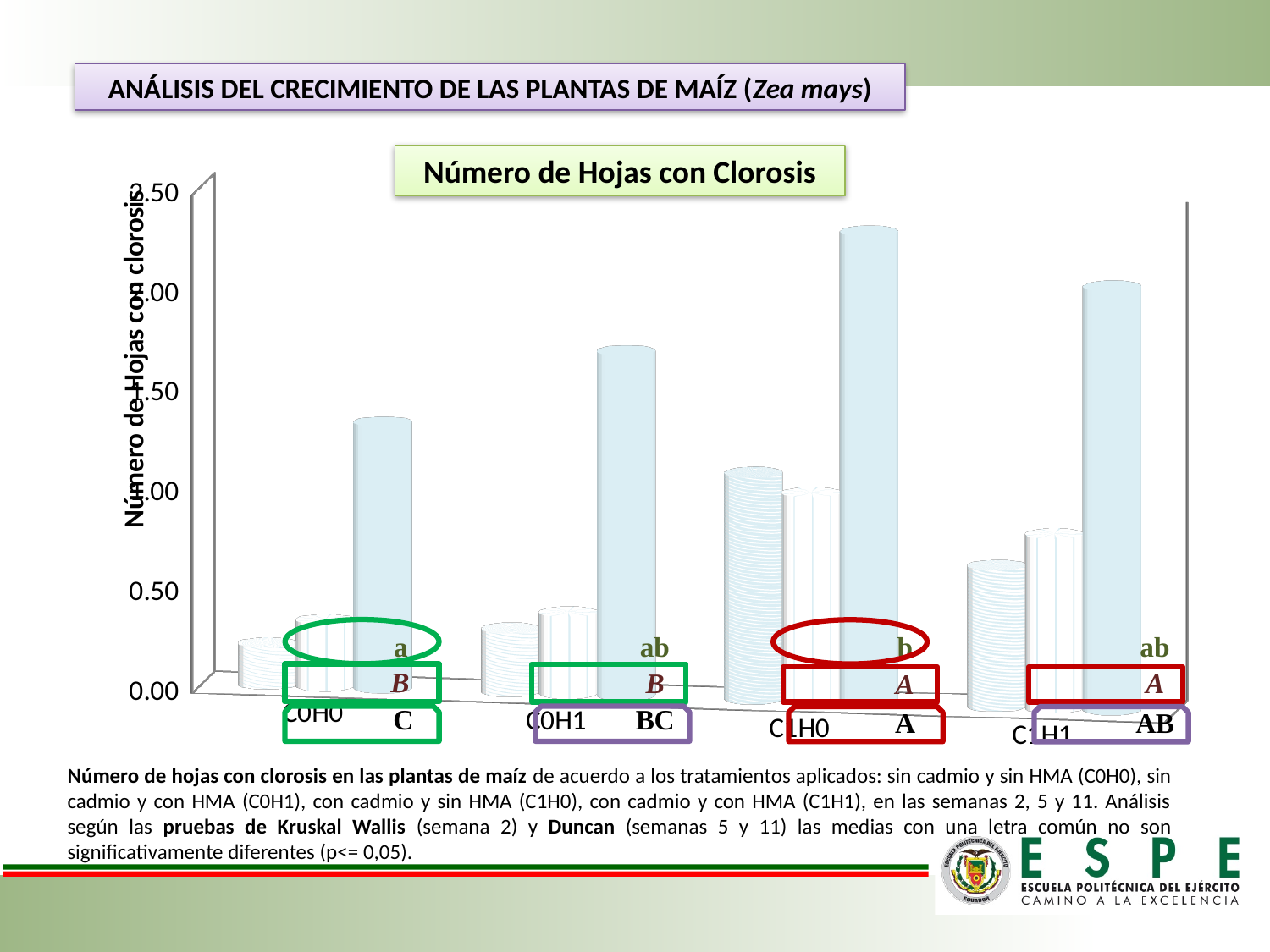
How many bars are plotted for each treatment category in the chart? 3 Is the tallest bar for C0H0 greater or less than 1.00? greater Which has the taller tallest bar, C1H0 or C0H0? C1H0 Is the shortest bar for C0H1 greater or less than 0.50? less What kind of chart is shown on the slide? bar chart Which treatment category contains the shortest bar in the chart? C0H0 What is the title of the chart? Número de Hojas con Clorosis Is the tallest bar for C1H0 greater or less than 2.00? greater Which treatment category contains the tallest bar in the chart? C1H0 How many treatment categories are shown on the x axis of the chart? 4 What is the highest tick value shown on the vertical axis of the chart? 2.50